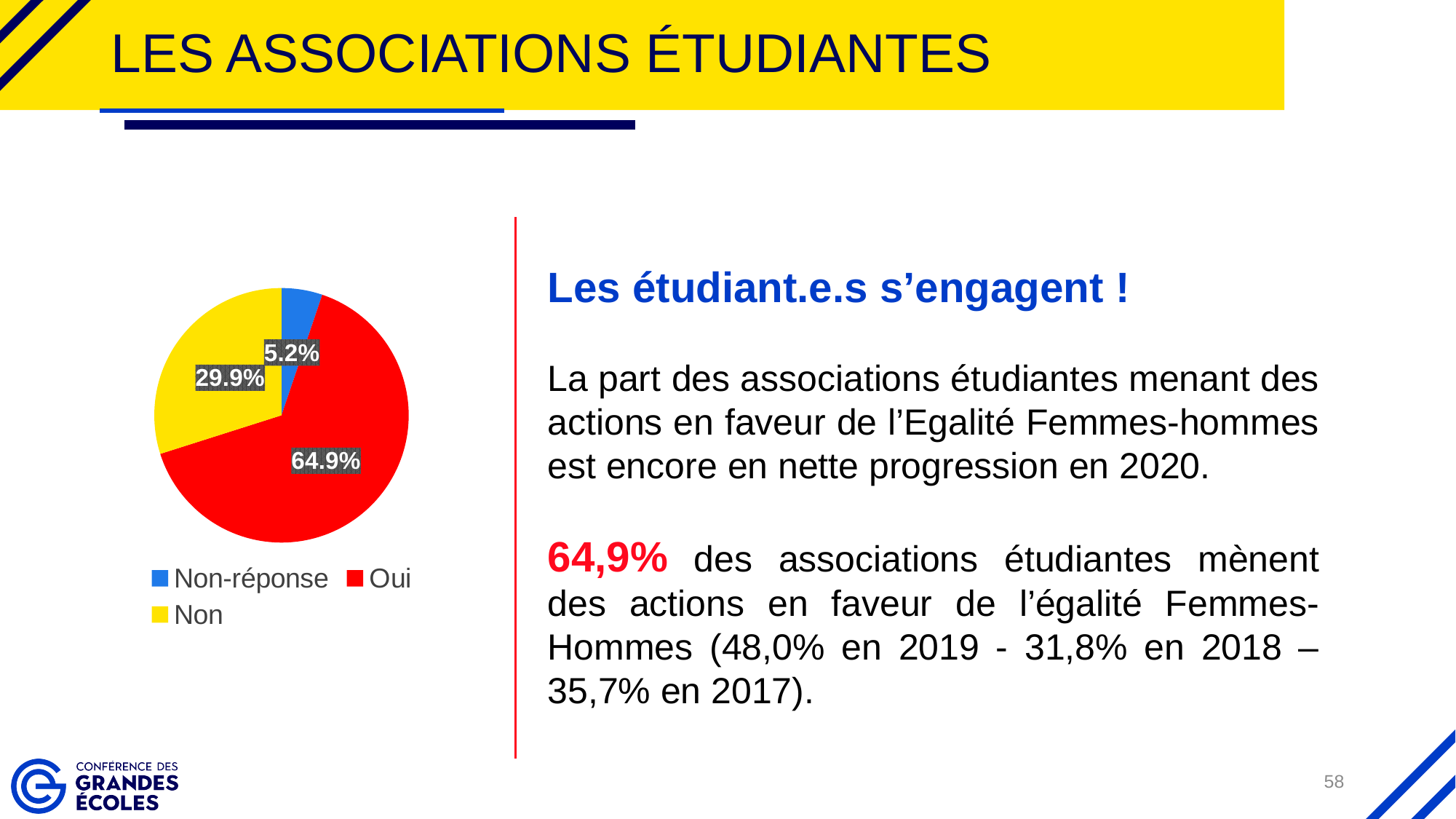
Which category has the largest slice of the pie? Oui What share of the pie does the "Oui" slice represent? 64.9% Which slice is larger, "Non" or "Non-réponse"? Non What is the difference in percentage points between the "Oui" and "Non" slices? 35.0 Which category has the smallest slice of the pie? Non-réponse How many slices does the pie chart have? 3 What share of the pie does the "Non" slice represent? 29.9% What type of chart is shown on the slide? pie chart How many entries does the legend list? 3 What colour is the "Non" slice in the pie chart? yellow What colour is the "Oui" slice in the pie chart? red What share of the pie does the "Non-réponse" slice represent? 5.2%